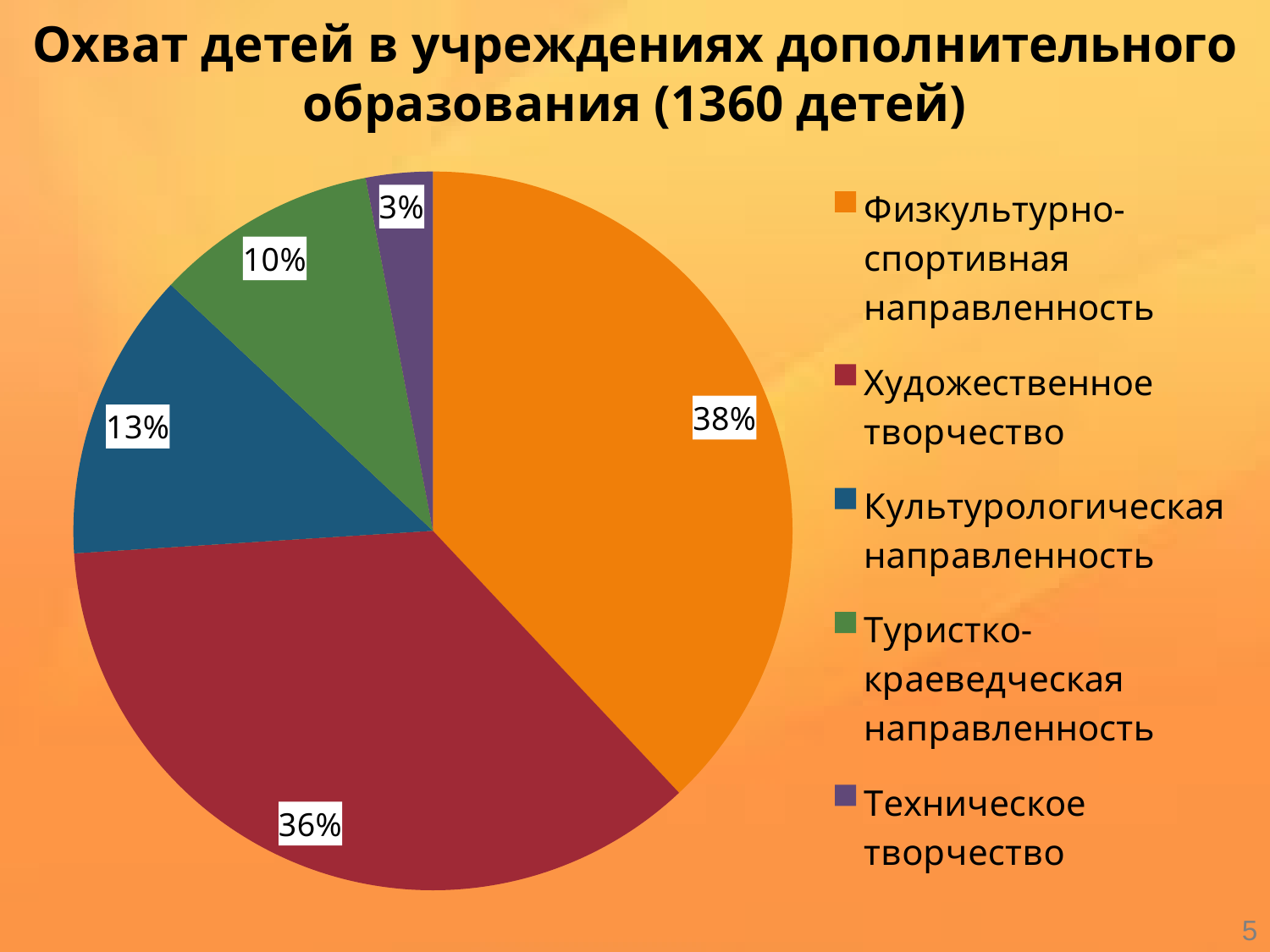
Which category has the smallest slice of the pie? Техническое творчество What is the difference in percentage points between Физкультурно-спортивная направленность and Художественное творчество? 2% How many categories does the pie chart show? 5 What share of the pie does Художественное творчество have? 36% Which is larger: the share for Культурологическая направленность or the share for Туристко-краеведческая направленность? Культурологическая направленность What share of the pie does Культурологическая направленность have? 13% What share of the pie does Физкультурно-спортивная направленность have? 38% What colour is the slice for Художественное творчество? Dark red Which category has the largest slice of the pie? Физкультурно-спортивная направленность What kind of chart is shown on the slide? Pie chart